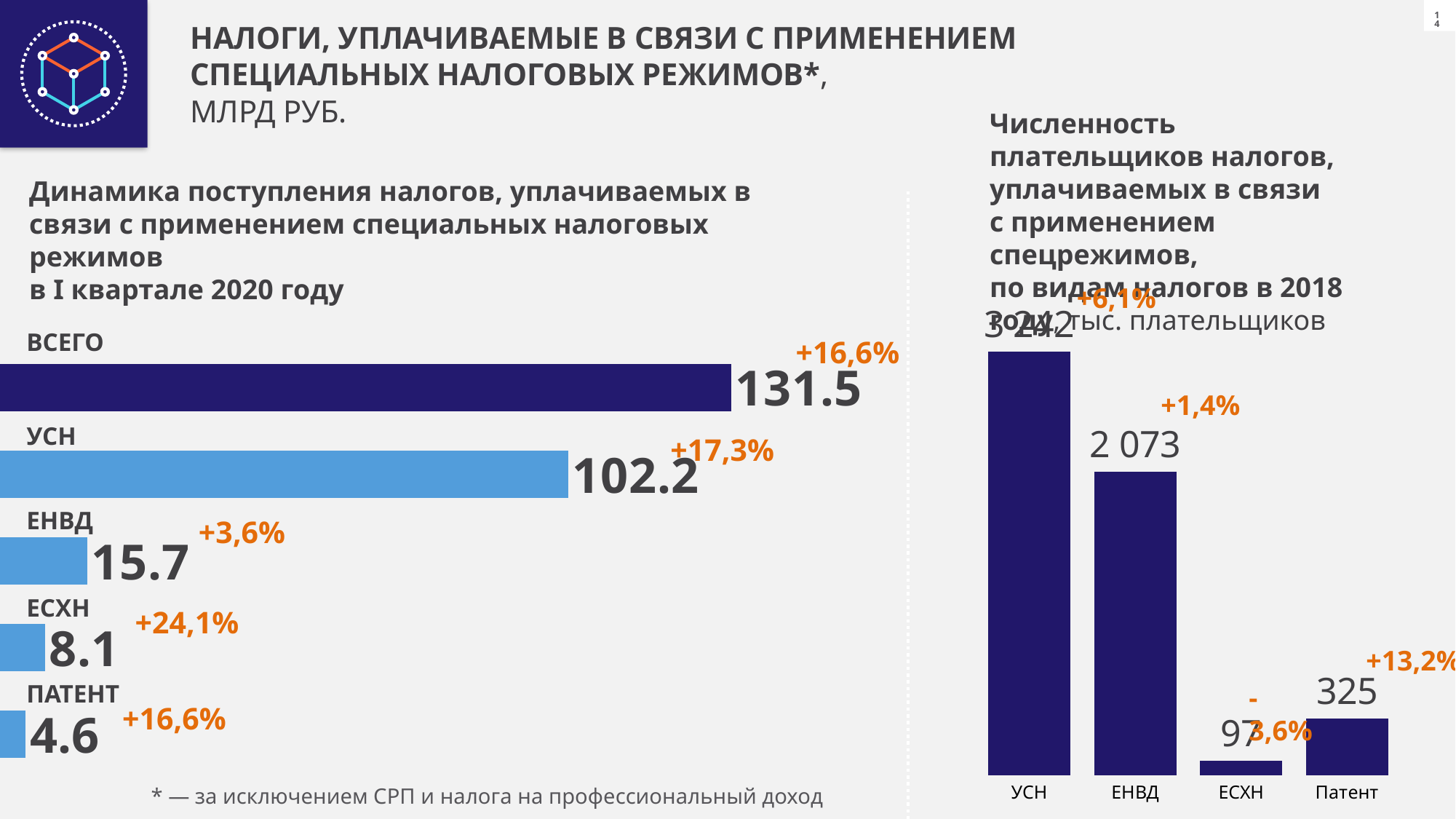
In the left chart (Динамика поступления налогов), what is the value for УСН? 102.2 In the left chart (Динамика поступления налогов), which is larger, the value for ЕСХН or the value for ПАТЕНТ? ЕСХН In the right chart (Численность плательщиков налогов), what is the value for Патент? 325 In the left chart (Динамика поступления налогов), which of the individual tax regimes (excluding ВСЕГО) has the lowest value? ПАТЕНТ What kind of chart is the left chart (Динамика поступления налогов)? bar chart In the left chart (Динамика поступления налогов), what is the value for ПАТЕНТ? 4.6 In the left chart (Динамика поступления налогов), what is the difference between the values for УСН and ЕНВД? 86.5 In the left chart (Динамика поступления налогов), what is the value for ВСЕГО? 131.5 In the left chart (Динамика поступления налогов), what growth percentage is shown next to ЕСХН? +24,1% In the left chart (Динамика поступления налогов), what is the value for ЕНВД? 15.7 In the right chart (Численность плательщиков налогов), which category has the highest value? УСН In the right chart (Численность плательщиков налогов), what is the value for ЕНВД? 2 073